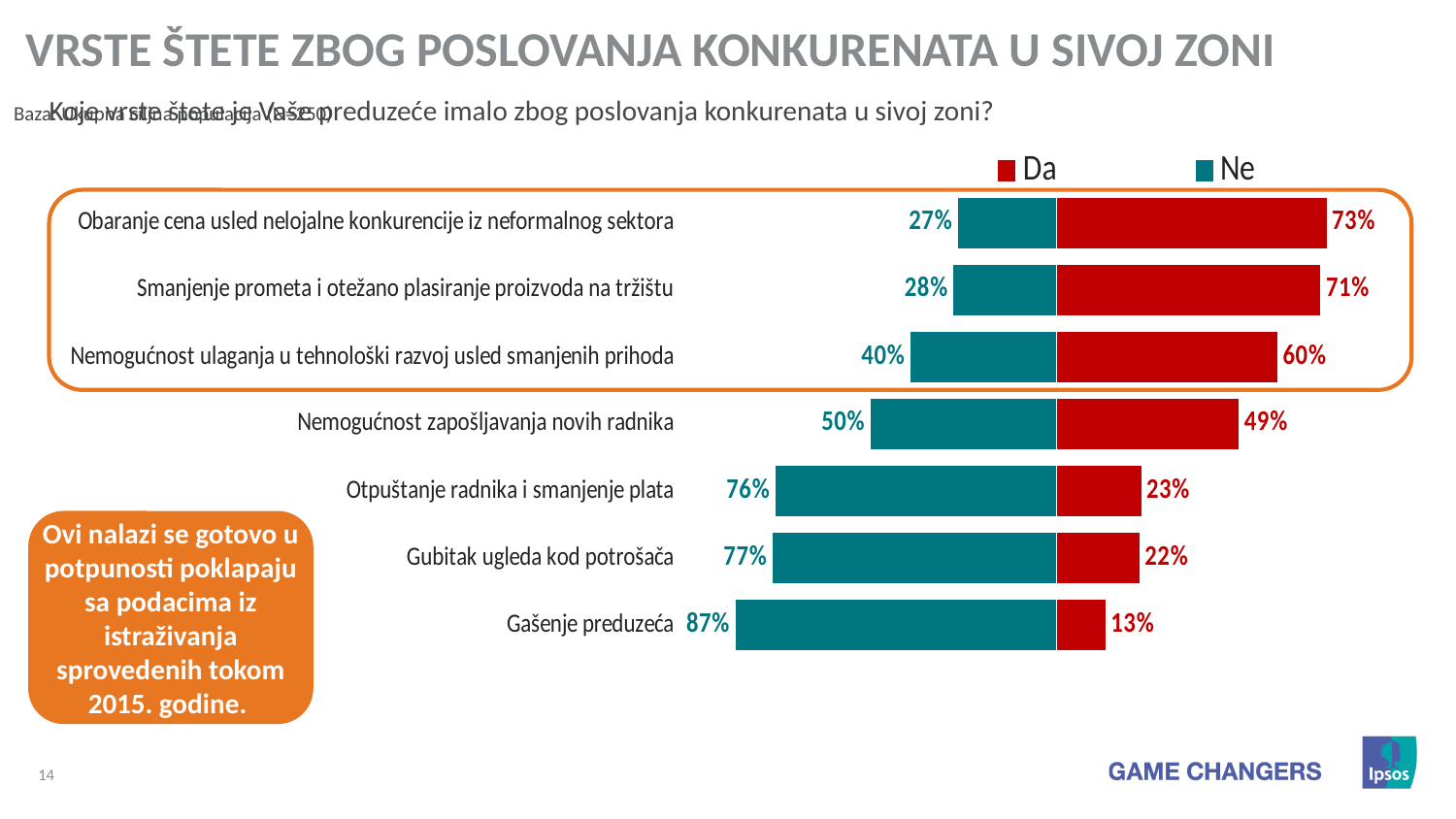
Which category has the highest "Da" value? Obaranje cena usled nelojalne konkurencije iz neformalnog sektora How many series does the legend list? 2 What is the "Ne" value for "Nemogućnost ulaganja u tehnološki razvoj usled smanjenih prihoda"? 40% Which colour represents the "Da" series in the chart? Red What is the "Da" value for "Nemogućnost zapošljavanja novih radnika"? 49% What is the "Ne" value for "Gašenje preduzeća"? 87% Which is larger: the "Ne" value for "Otpuštanje radnika i smanjenje plata" or the "Ne" value for "Gubitak ugleda kod potrošača"? Gubitak ugleda kod potrošača Which category has the lowest "Da" value? Gašenje preduzeća What kind of chart is shown on the slide? Bar chart What is the difference between the "Da" values for "Smanjenje prometa i otežano plasiranje proizvoda na tržištu" and "Nemogućnost ulaganja u tehnološki razvoj usled smanjenih prihoda"? 11% How many categories are shown in the chart? 7 What percentage of respondents answered "Da" for "Obaranje cena usled nelojalne konkurencije iz neformalnog sektora"? 73%